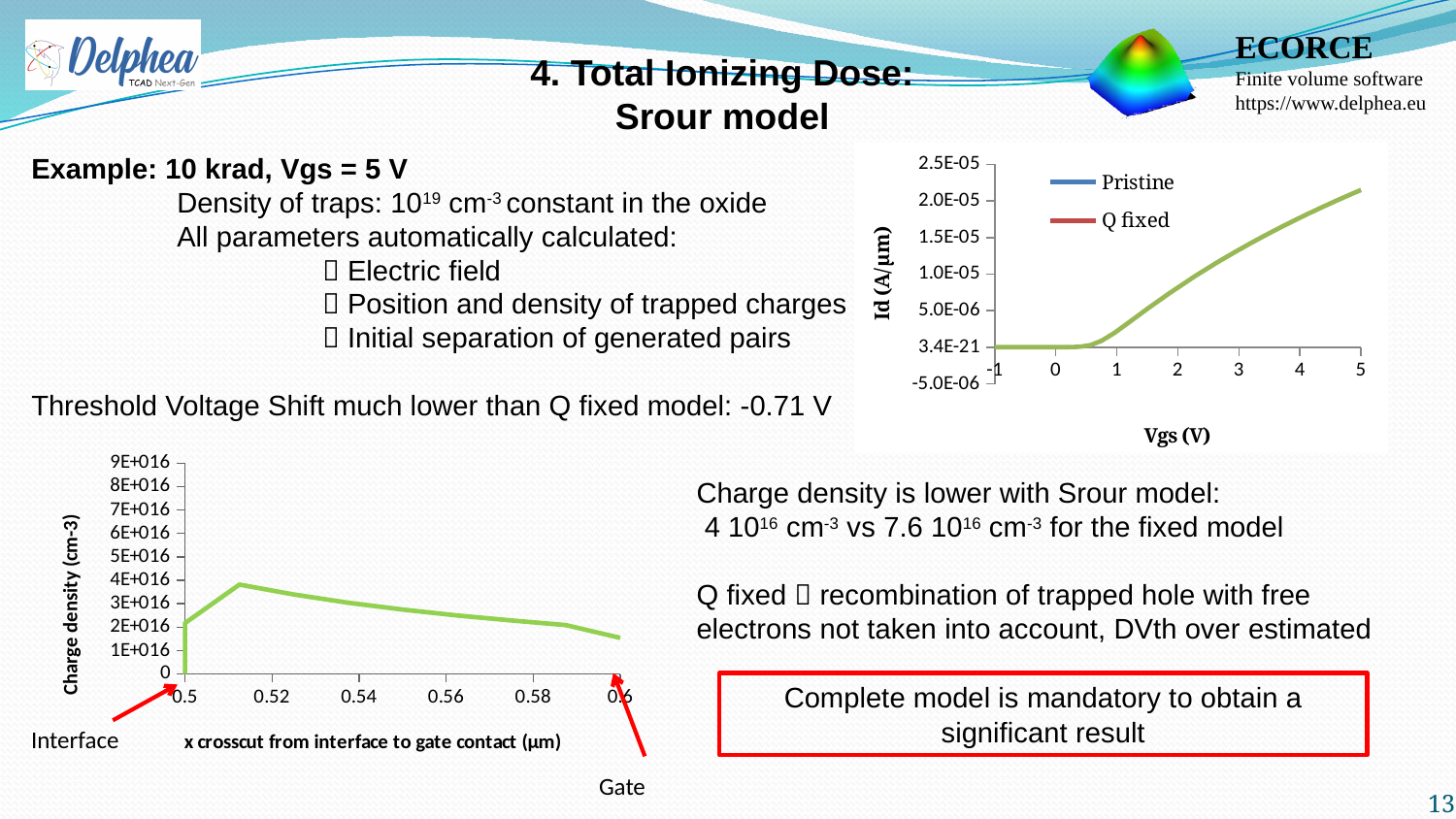
In the top-right chart (Id versus Vgs), is the value of Id at Vgs = 4 greater or less than 1.0E-05? greater In the top-right chart (Id versus Vgs), what are the two series named in the legend? Pristine and Q fixed In the top-right chart (Id versus Vgs), is the value of Id at Vgs = 2 greater or less than 1.0E-05? less What kind of chart is the chart in the bottom left of the slide (charge density versus x crosscut)? line chart In the top-right chart (Id versus Vgs), does Id rise or fall as Vgs increases from 1 to 5? rise In the bottom-left chart (charge density versus x crosscut), is the charge density at x = 0.6 greater or less than 2E+016? less In the bottom-left chart (charge density versus x crosscut), does the charge density rise or fall along the x axis from 0.52 to 0.6? fall In the bottom-left chart (charge density versus x crosscut), what is the label of the x axis? x crosscut from interface to gate contact (µm) How many series does the legend of the top-right chart (Id versus Vgs) list? 2 What kind of chart is the chart in the top right of the slide (Id versus Vgs)? line chart